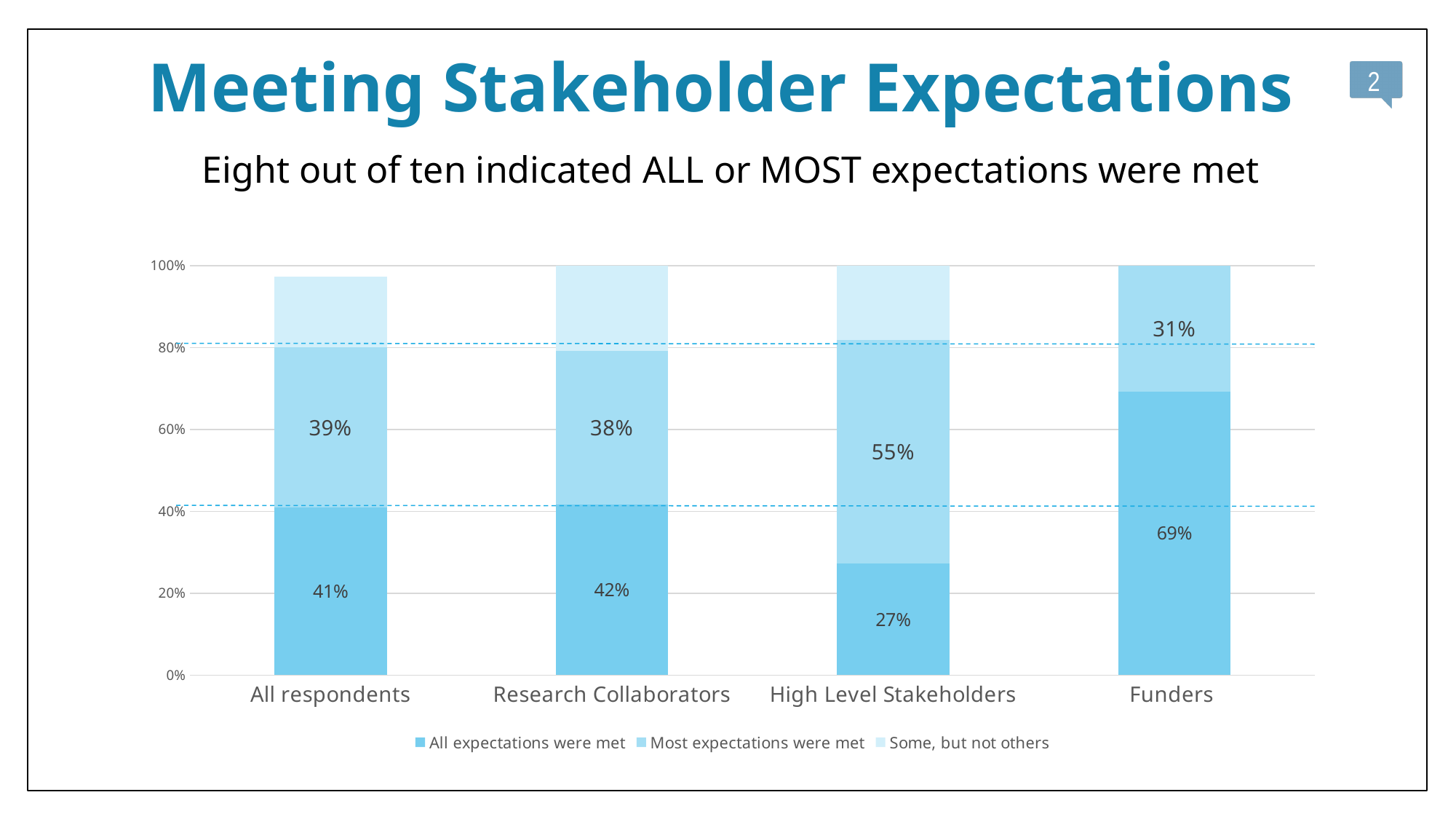
Which group has the lowest percentage for 'All expectations were met'? High Level Stakeholders Which is larger for High Level Stakeholders: 'All expectations were met' or 'Most expectations were met'? Most expectations were met Which group has the highest percentage for 'All expectations were met'? Funders What kind of chart is shown on the slide? Stacked bar chart How many series does the legend list? 3 What percentage of Funders said most expectations were met? 31% What percentage of All respondents said all expectations were met? 41% How many respondent groups are shown on the x axis? 4 What is the combined percentage of All respondents who said all or most expectations were met? 80% What percentage of Research Collaborators said all expectations were met? 42% What is the difference between the 'All expectations were met' percentages for Funders and High Level Stakeholders? 42% What percentage of High Level Stakeholders said most expectations were met? 55%